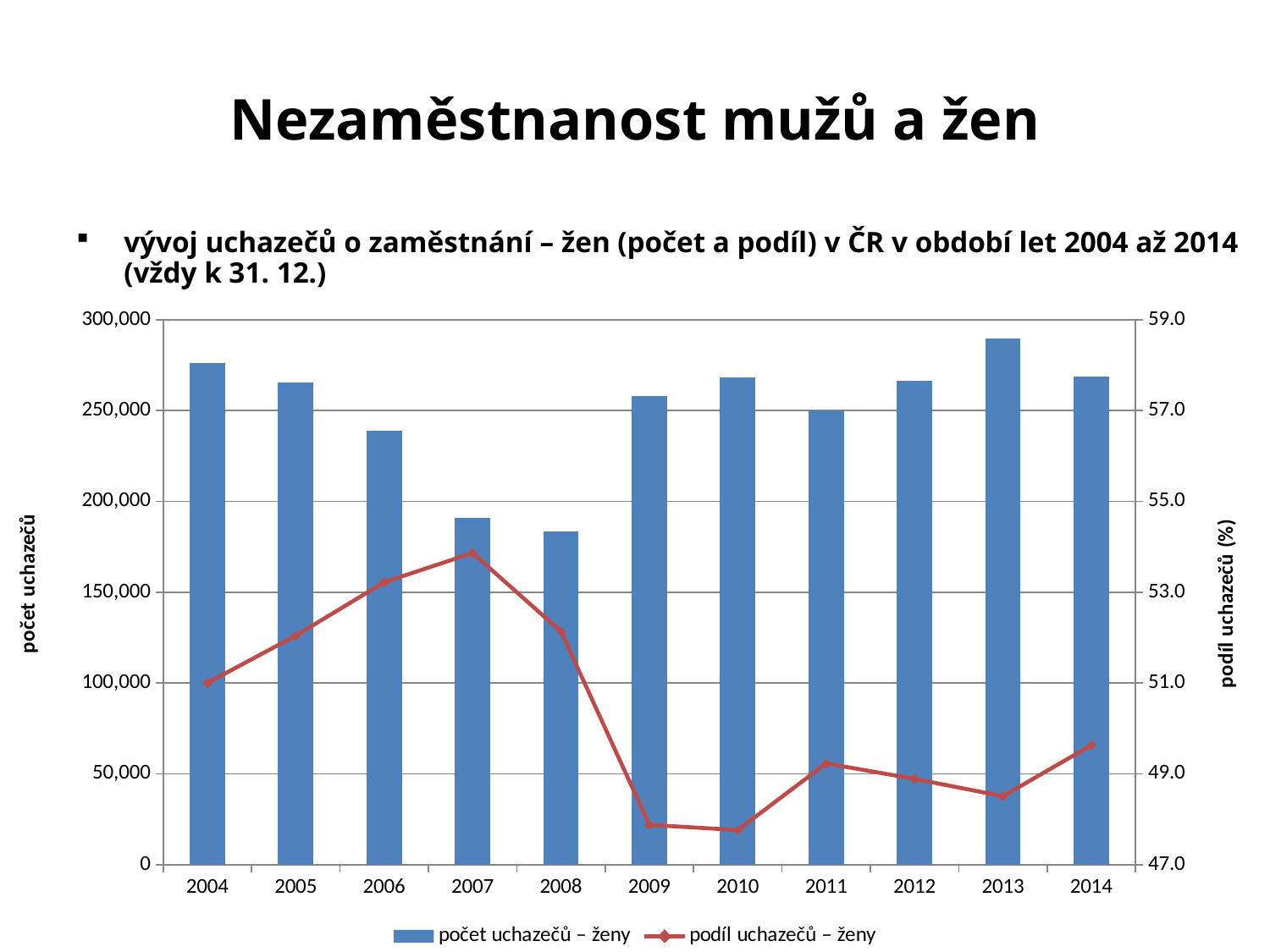
In which year does the line podíl uchazečů – ženy reach its highest value? 2007 Is the value of podíl uchazečů – ženy for 2009 greater or less than 49.0? less In which year is the bar for počet uchazečů – ženy the highest? 2013 Does the line podíl uchazečů – ženy rise or fall from 2004 to 2007? rise Is the value of počet uchazečů – ženy for 2007 greater or less than 200,000? less What kind of chart is shown on the slide? A combined bar and line chart Is the value of počet uchazečů – ženy for 2013 greater or less than 250,000? greater What is the label of the right-hand vertical axis? podíl uchazečů (%) How many years are shown on the x axis? 11 How many series does the legend list? 2 In which year is the bar for počet uchazečů – ženy the lowest? 2008 Which year has the larger bar for počet uchazečů – ženy, 2004 or 2005? 2004